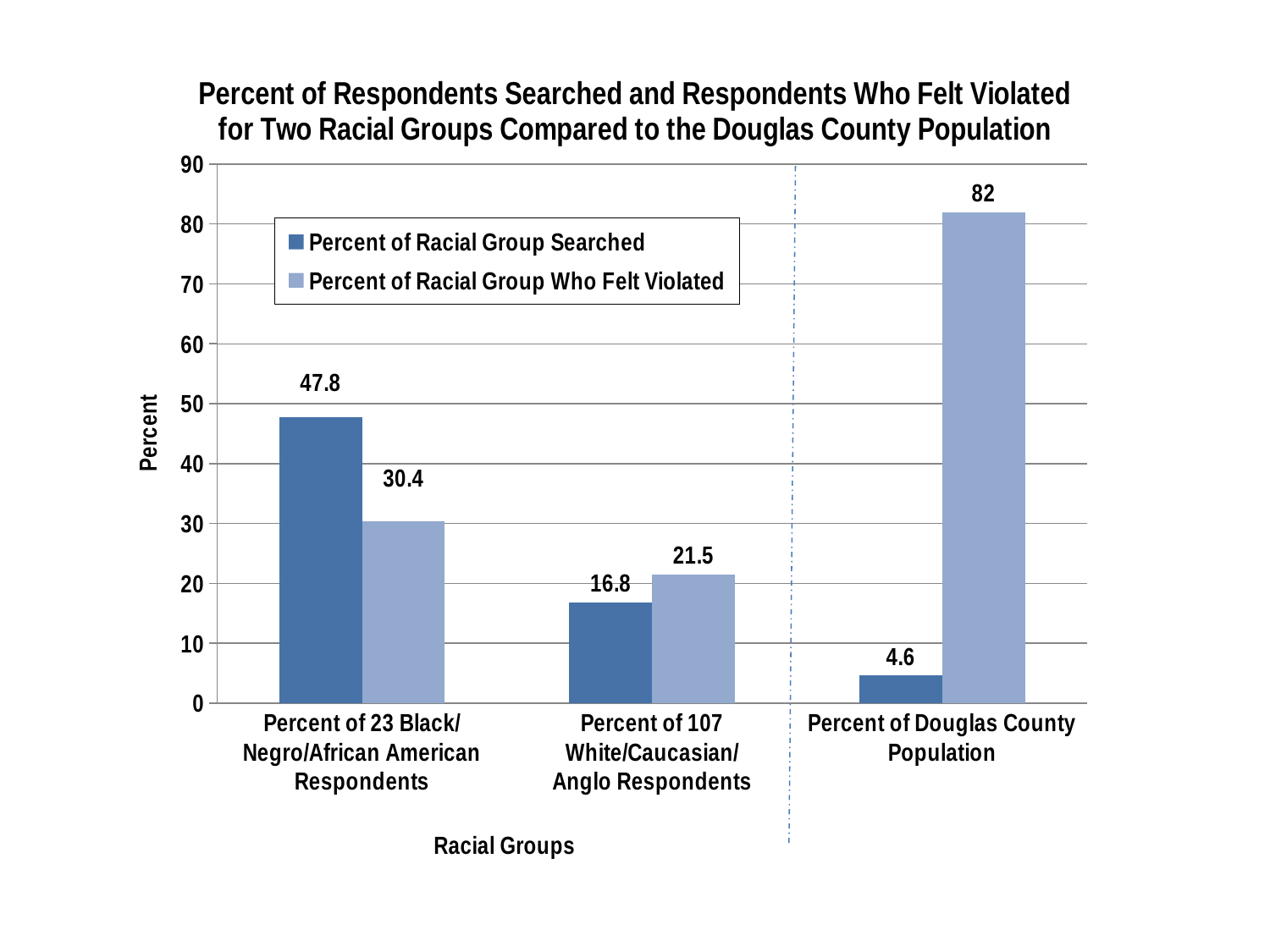
How many series does the legend list? 2 What is the difference between Percent of Racial Group Searched and Percent of Racial Group Who Felt Violated for the Black/Negro/African American Respondents category? 17.4 How many categories are shown on the x axis? 3 What is the value of Percent of Racial Group Who Felt Violated for the Douglas County Population category? 82 Which category has the highest value for Percent of Racial Group Searched? Percent of 23 Black/Negro/African American Respondents What kind of chart is shown on the slide? Bar chart For the White/Caucasian/Anglo Respondents category, which is larger: Percent of Racial Group Searched or Percent of Racial Group Who Felt Violated? Percent of Racial Group Who Felt Violated What is the value of Percent of Racial Group Searched for the Douglas County Population category? 4.6 What is the value of Percent of Racial Group Searched for the Black/Negro/African American Respondents category? 47.8 Which category has the lowest value for Percent of Racial Group Who Felt Violated? Percent of 107 White/Caucasian/Anglo Respondents What is the value of Percent of Racial Group Who Felt Violated for the White/Caucasian/Anglo Respondents category? 21.5 What is the label of the y axis? Percent